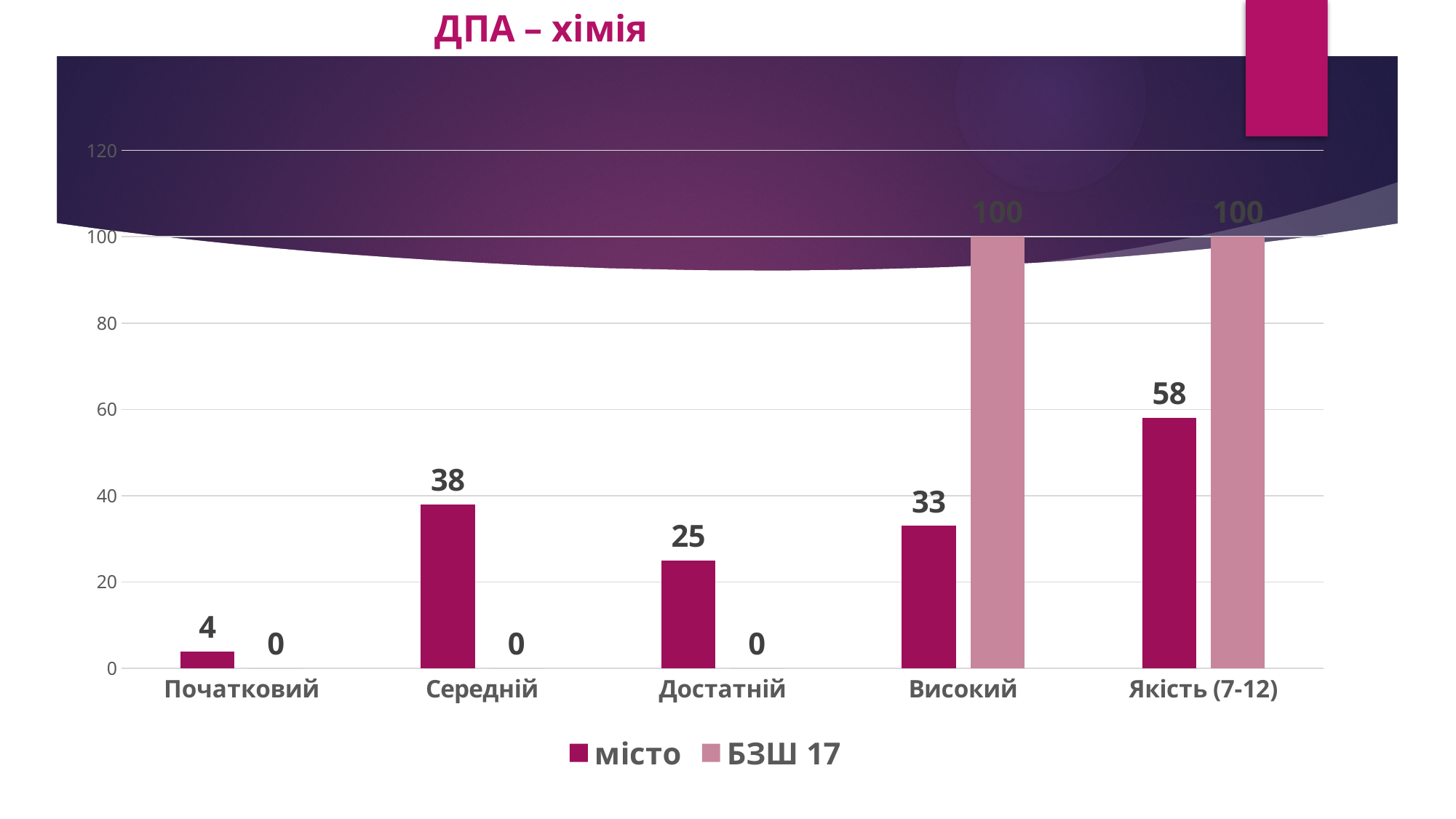
What is the value for місто in the Початковий category? 4 What is the value for БЗШ 17 in the Високий category? 100 How many categories are shown on the x axis? 5 What is the difference between the БЗШ 17 and місто values in the Якість (7-12) category? 42 Which category has the lowest value for місто? Початковий What is the value for місто in the Середній category? 38 What is the title of the chart? ДПА – хімія How many series does the legend list? 2 What is the value for БЗШ 17 in the Достатній category? 0 What kind of chart is shown on the slide? bar chart In the Високий category, which series has the larger value, місто or БЗШ 17? БЗШ 17 Which category has the highest value for місто? Якість (7-12)